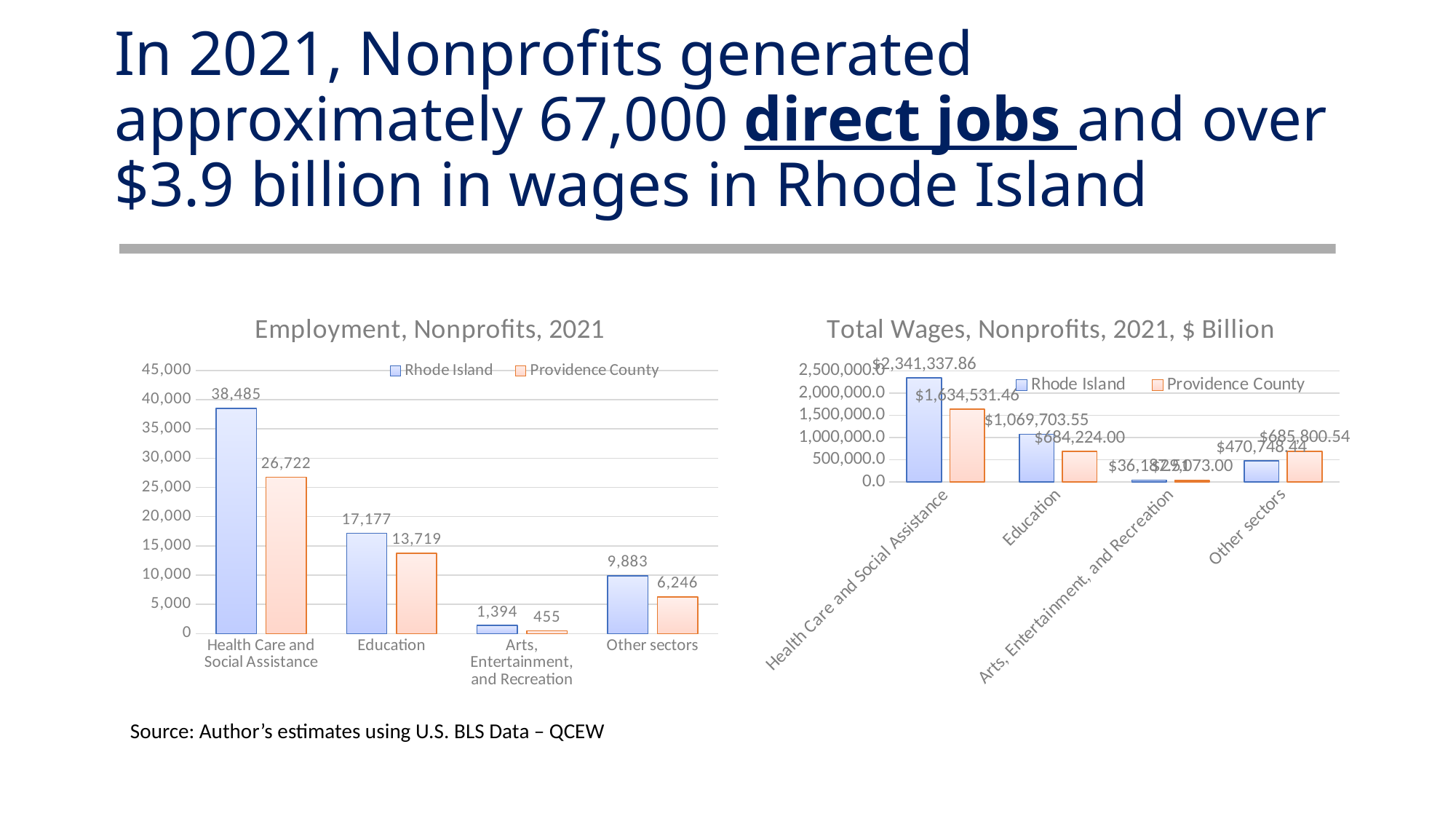
In the Total Wages, Nonprofits, 2021, $ Billion chart, which is larger for Education: the Rhode Island value or the Providence County value? Rhode Island What kind of chart is the Employment, Nonprofits, 2021 chart? Bar chart In the Total Wages, Nonprofits, 2021, $ Billion chart, what is the Rhode Island value for Health Care and Social Assistance? $2,341,337.86 In the Employment, Nonprofits, 2021 chart, is the Rhode Island value for Education greater or less than 15,000? greater In the Employment, Nonprofits, 2021 chart, what is the Providence County value for Education? 13,719 In the Total Wages, Nonprofits, 2021, $ Billion chart, what is the Providence County value for Education? $684,224.00 In the Employment, Nonprofits, 2021 chart, which category has the lowest Rhode Island value? Arts, Entertainment, and Recreation How many series does the legend of the Total Wages, Nonprofits, 2021, $ Billion chart list? 2 In the Employment, Nonprofits, 2021 chart, what is the difference between the Rhode Island and Providence County values for Other sectors? 3,637 In the Total Wages, Nonprofits, 2021, $ Billion chart, which category has the highest Rhode Island value? Health Care and Social Assistance In the Employment, Nonprofits, 2021 chart, what is the Rhode Island value for Health Care and Social Assistance? 38,485 In the Employment, Nonprofits, 2021 chart, how many categories are shown on the x axis? 4